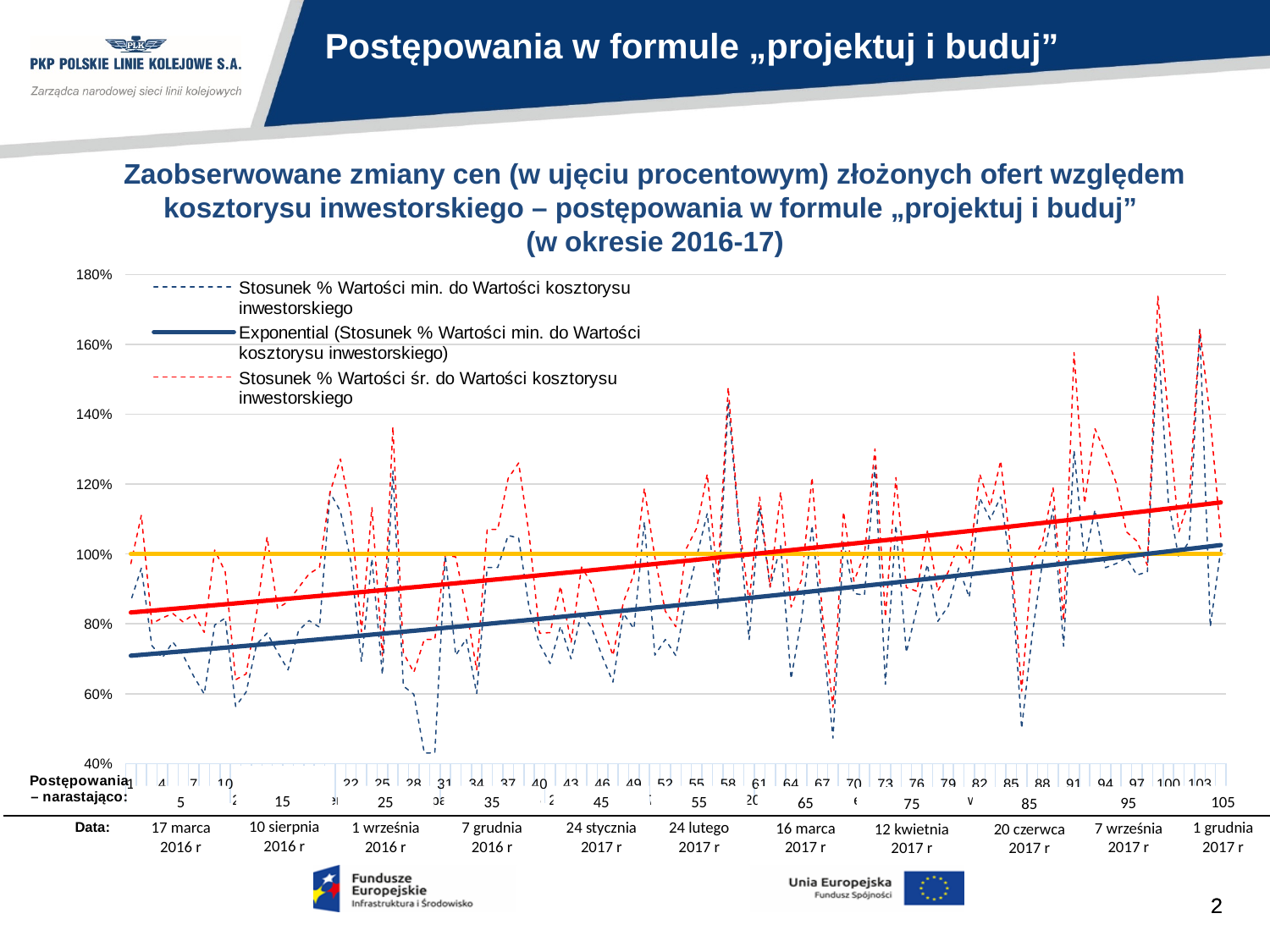
Is the value of the solid blue 'Exponential' trend line at the left edge of the chart greater or less than 80%? less How many series does the chart legend list? 3 What is the highest value shown on the vertical axis of the chart? 180% Does the solid red trend line rise or fall from left to right along the x axis? rises Does the solid blue 'Exponential' trend line rise or fall from left to right along the x axis? rises Is the value of the solid red trend line at the right edge of the chart greater or less than 100%? greater What is the last number shown on the 'Postępowania – narastająco' axis at the bottom of the chart? 105 At what percentage level does the horizontal yellow line run across the chart? 100% What is the first date shown in the 'Data' row under the chart? 17 marca 2016 r What kind of chart is shown on the slide? line chart What is the lowest value shown on the vertical axis of the chart? 40% What is the last date shown in the 'Data' row under the chart? 1 grudnia 2017 r